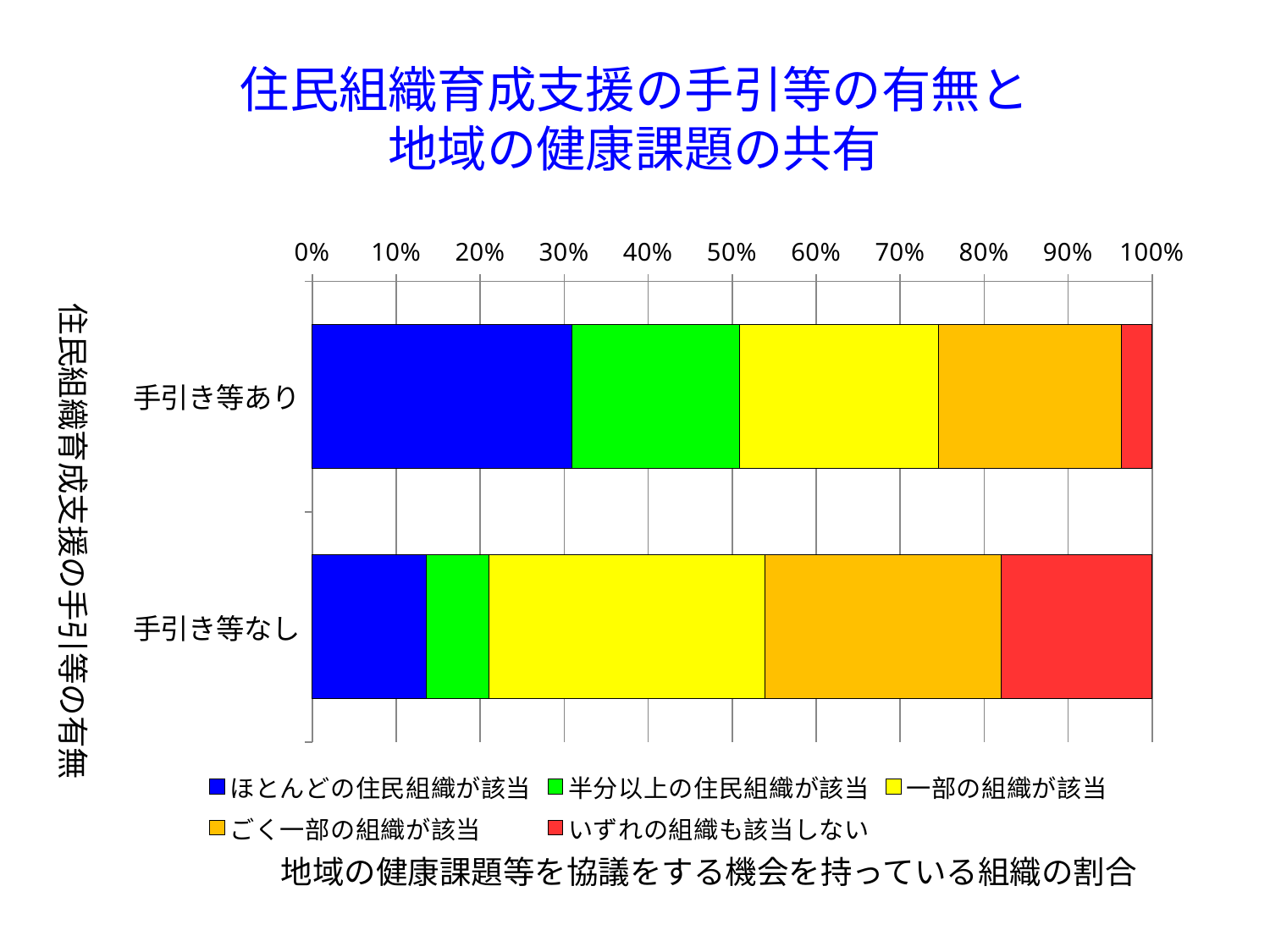
Is the いずれの組織も該当しない value for 手引き等あり greater or less than 10%? less How many series does the legend list? 5 Which category has the larger いずれの組織も該当しない segment, 手引き等あり or 手引き等なし? 手引き等なし Which legend entry is shown in red? いずれの組織も該当しない Which category has the larger ほとんどの住民組織が該当 segment, 手引き等あり or 手引き等なし? 手引き等あり What is the title of the chart? 住民組織育成支援の手引等の有無と地域の健康課題の共有 Is the いずれの組織も該当しない value for 手引き等なし greater or less than 10%? greater Is the ほとんどの住民組織が該当 value for 手引き等あり greater or less than 20%? greater What is the total of the stacked bar for 手引き等あり? 100% How many categories are shown on the vertical axis of the chart? 2 What kind of chart is shown on the slide? stacked bar chart